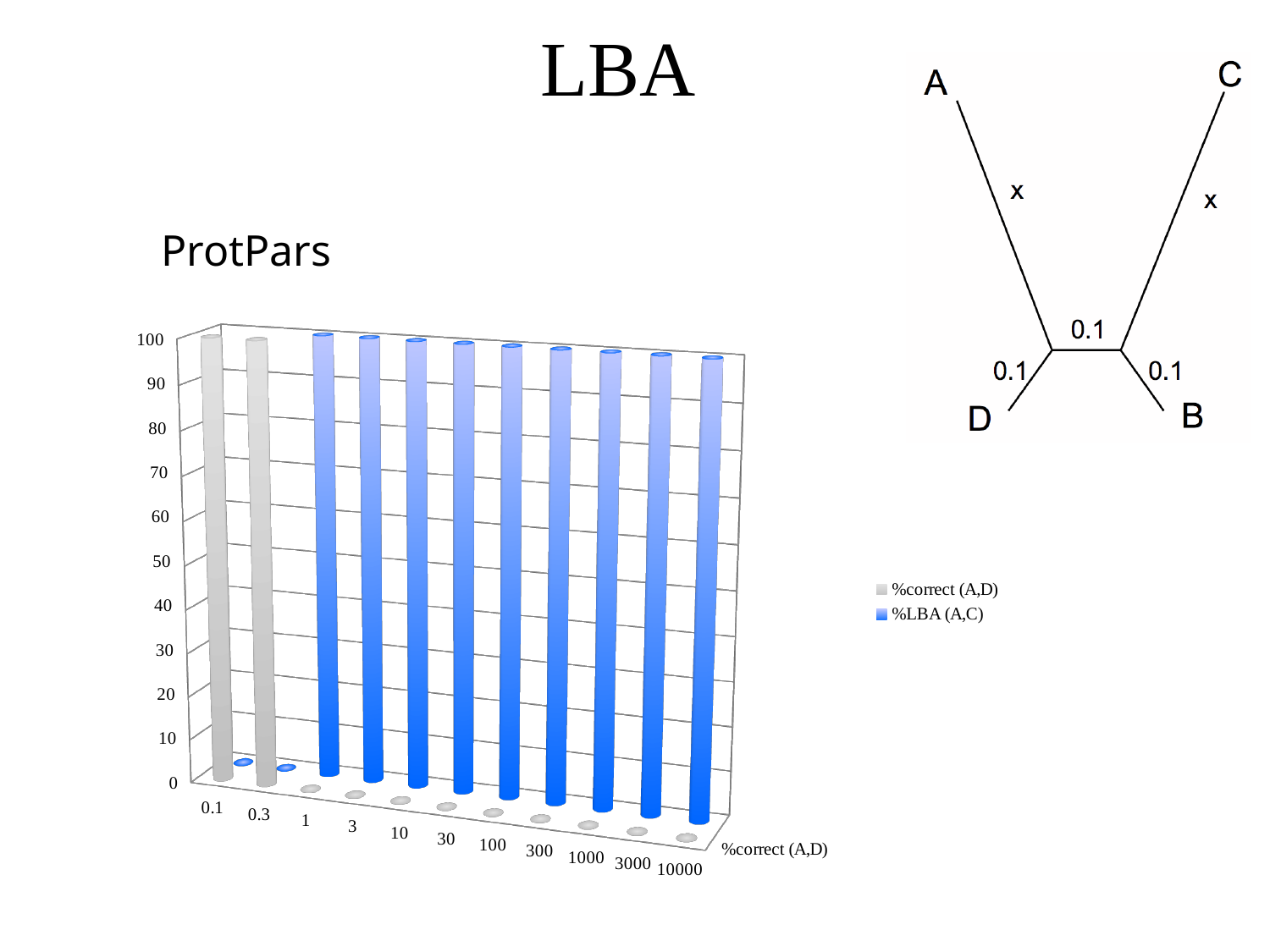
In the ProtPars chart, which series has the larger value at 0.3: %correct (A,D) or %LBA (A,C)? %correct (A,D) In the ProtPars chart, is the %correct (A,D) value at 0.1 greater or less than 90? greater In the ProtPars chart, is the %correct (A,D) value at 1000 greater or less than 10? less In the ProtPars chart, does the %correct (A,D) series rise or fall as the x axis goes from 0.3 to 1? fall What is the title of the chart on the slide? ProtPars In the ProtPars chart, which series has the larger value at 10: %correct (A,D) or %LBA (A,C)? %LBA (A,C) What kind of chart is the ProtPars chart? bar chart In the ProtPars chart, is the %LBA (A,C) value at 100 greater or less than 90? greater Which colour represents the %LBA (A,C) series in the ProtPars chart? blue How many categories are shown on the x axis of the ProtPars chart? 11 How many series does the legend of the ProtPars chart list? 2